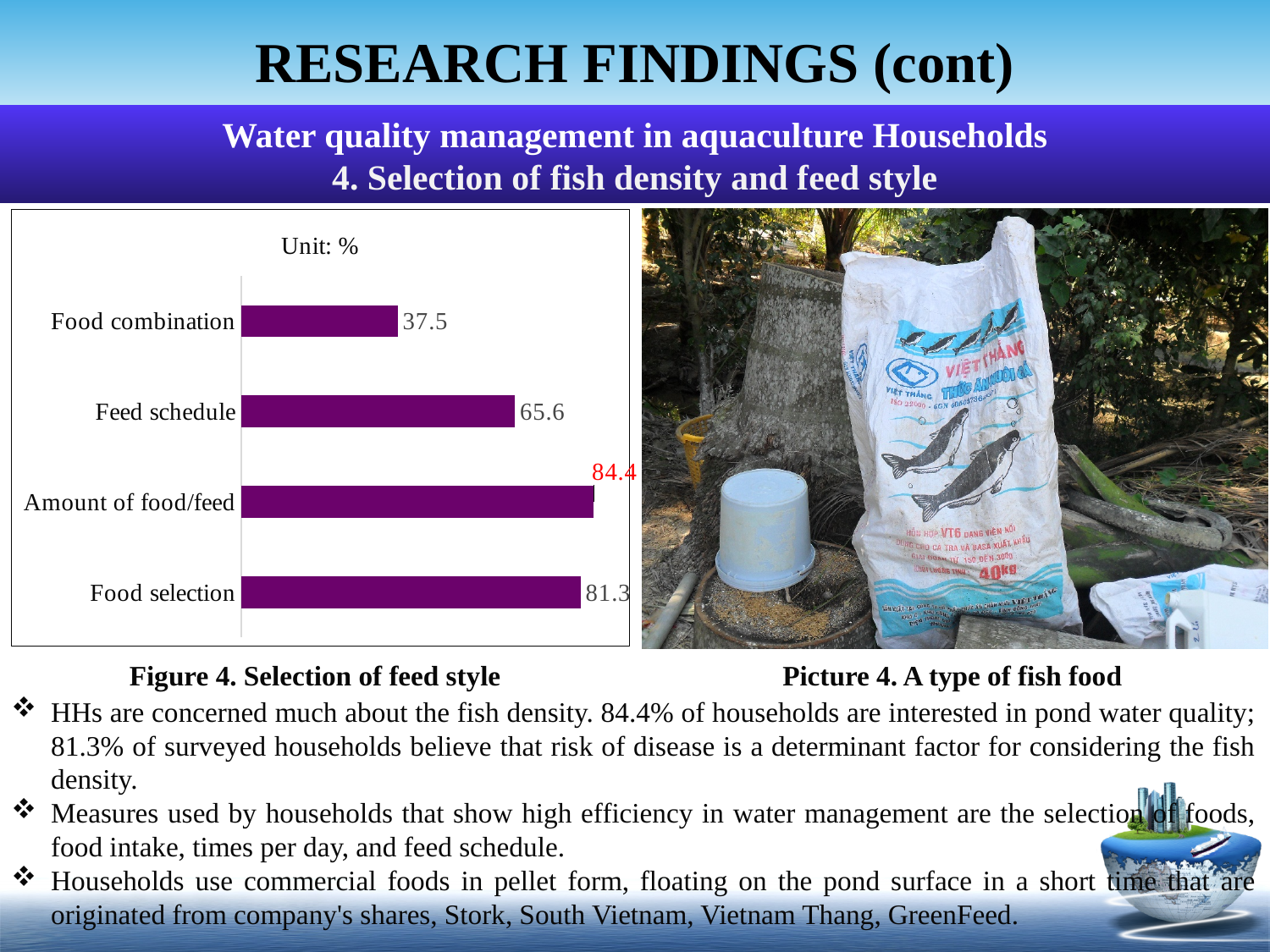
What is the value for Feed schedule? 65.6 What unit is stated above the chart? % Which is larger, the value for Feed schedule or the value for Food selection? Food selection Which category has the highest value? Amount of food/feed How many categories are shown in the chart? 4 What is the value for Food combination? 37.5 What is the difference between the values for Food selection and Feed schedule? 15.7 What is the value for Food selection? 81.3 What is the value for Amount of food/feed? 84.4 What is the difference between the values for Amount of food/feed and Food combination? 46.9 What kind of chart is shown on the slide? Bar chart Which category has the lowest value? Food combination